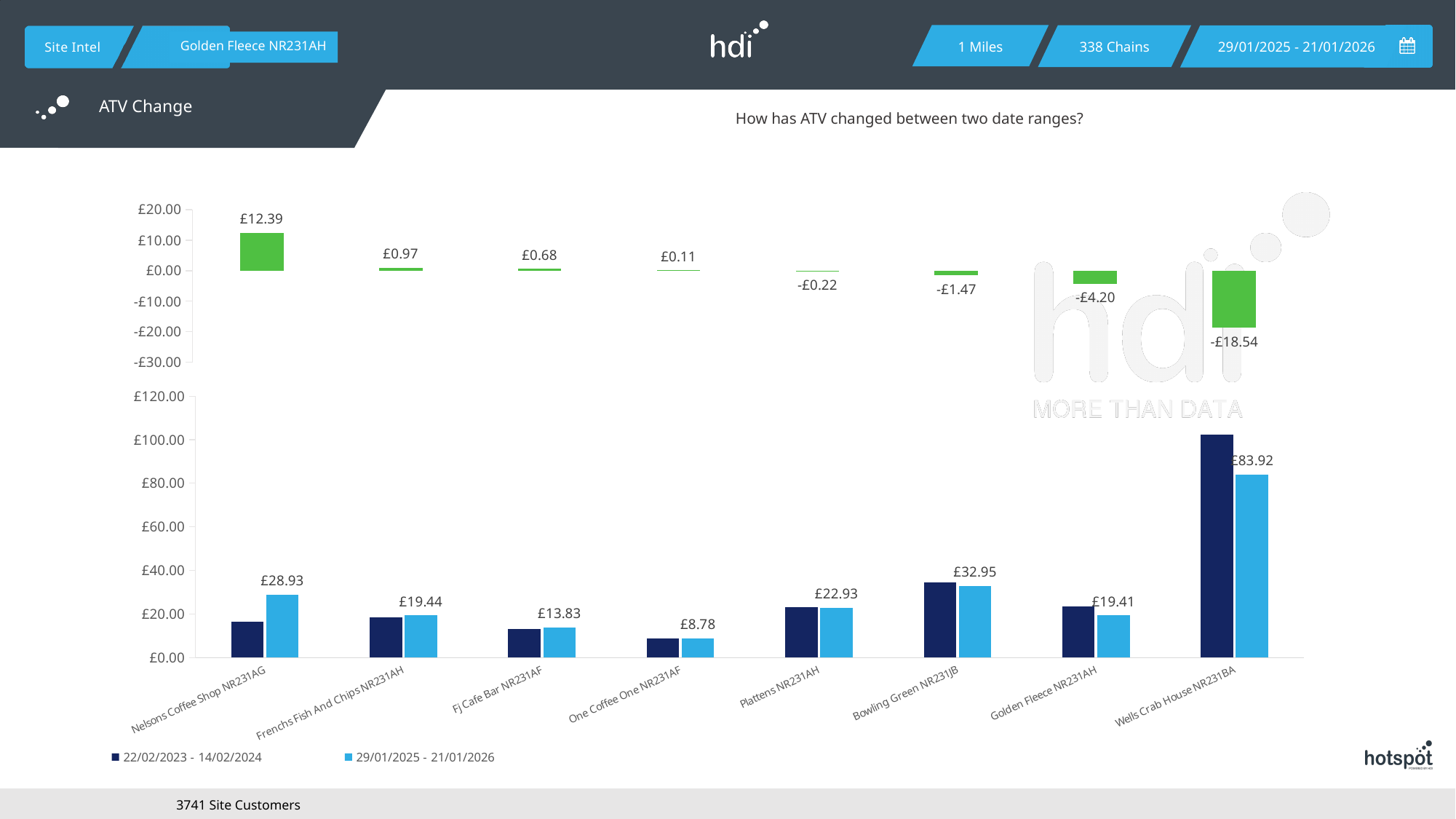
How many series does the legend of the bottom chart list? 2 In the bottom chart, which is larger for One Coffee One NR231AF: the 22/02/2023 - 14/02/2024 value or the 29/01/2025 - 21/01/2026 value? 29/01/2025 - 21/01/2026 In the top chart, what is the ATV change for Wells Crab House NR231BA? -£18.54 In the top chart, what is the ATV change for Nelsons Coffee Shop NR231AG? £12.39 In the bottom chart, what is the difference between Bowling Green NR231JB and Plattens NR231AH in the 29/01/2025 - 21/01/2026 period? £10.02 In the bottom chart, what is the value for Wells Crab House NR231BA in the 29/01/2025 - 21/01/2026 period? £83.92 In the top chart, what is the ATV change for Golden Fleece NR231AH? -£4.20 In the top chart, which site has the largest ATV change? Nelsons Coffee Shop NR231AG How many sites are shown on the x axis of the bottom chart? 8 In the top chart, which site has the lowest ATV change? Wells Crab House NR231BA In the bottom chart, what is the value for Bowling Green NR231JB in the 29/01/2025 - 21/01/2026 period? £32.95